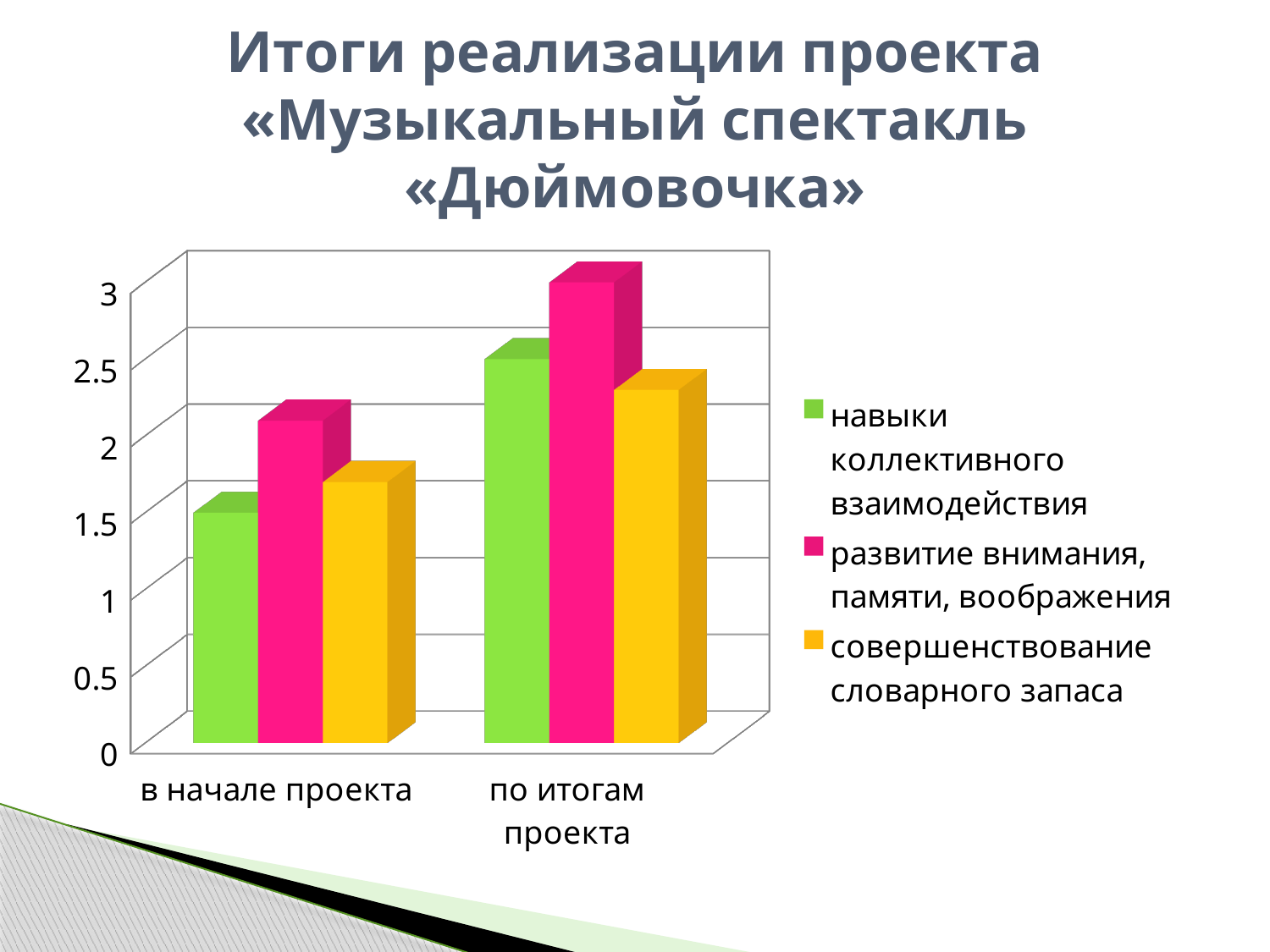
Which series has the highest bar in the category «по итогам проекта»? развитие внимания, памяти, воображения Which series has the lowest bar in the category «в начале проекта»? навыки коллективного взаимодействия Is the value for «совершенствование словарного запаса» in «по итогам проекта» greater or less than 2? greater Is the value for «навыки коллективного взаимодействия» in «в начале проекта» greater or less than 2? less Which is larger in «в начале проекта»: the bar for «развитие внимания, памяти, воображения» or the bar for «навыки коллективного взаимодействия»? развитие внимания, памяти, воображения How many categories are shown on the x axis of the chart? 2 Do the values for «навыки коллективного взаимодействия» rise or fall from «в начале проекта» to «по итогам проекта»? rise Is the value for «совершенствование словарного запаса» in «в начале проекта» greater or less than 2? less What colour represents the series «совершенствование словарного запаса» in the chart? yellow What kind of chart is shown on the slide? bar chart How many series does the chart legend list? 3